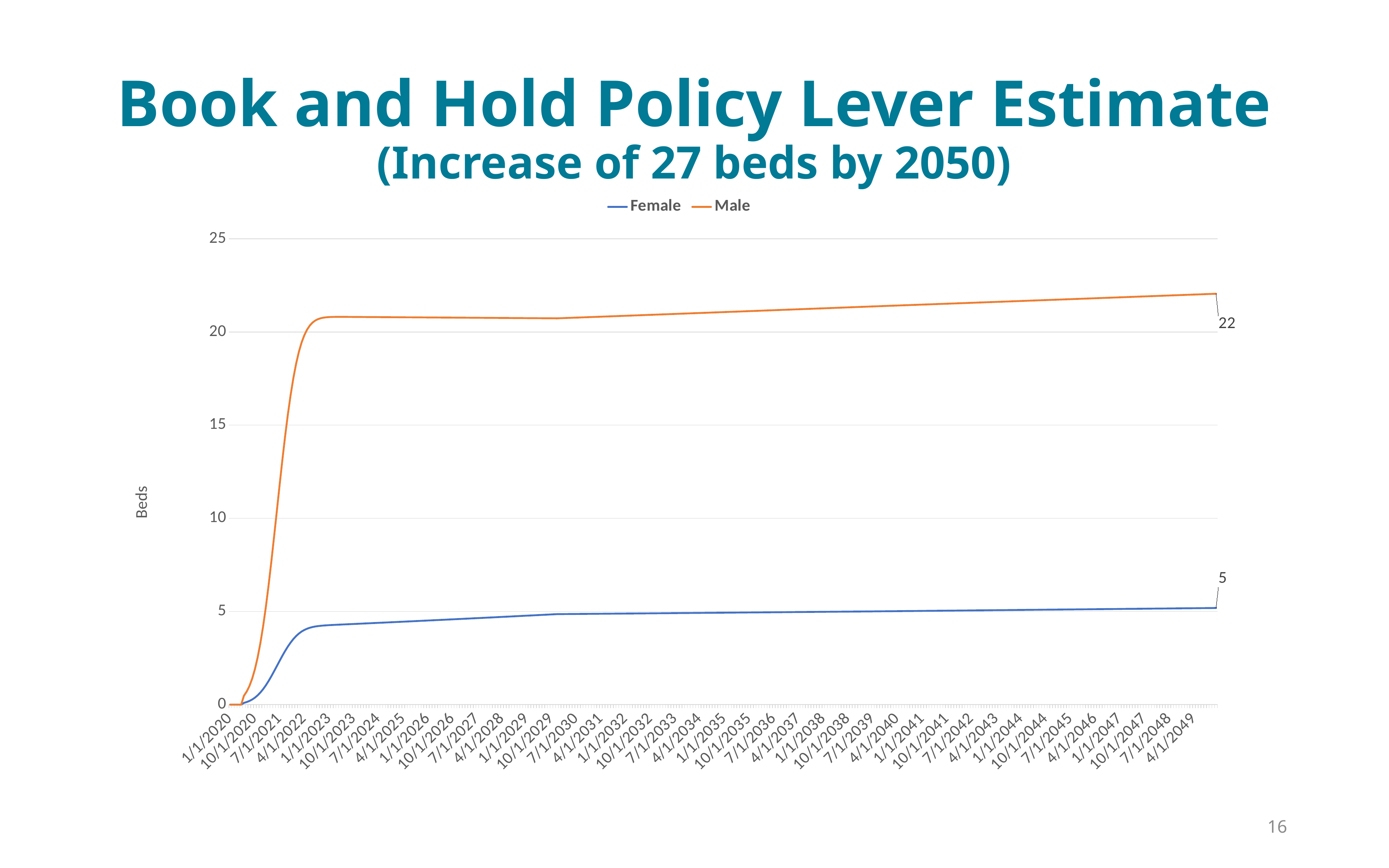
What is the title of the vertical axis? Beds Which series ends at a higher value, Male or Female? Male Which series has the higher values throughout the chart? Male What kind of chart is shown on the slide? line chart What is the sum of the final labelled values of the Male and Female series? 27 What is the difference between the final labelled values of the Male and Female series? 17 Is the value for the Female series at 1/1/2023 greater or less than 5? less How many series does the legend list? 2 What is the final labelled value for the Male series? 22 Does the Male series rise or fall from 1/1/2020 to 4/1/2049? rise What is the final labelled value for the Female series? 5 Is the value for the Male series at 1/1/2030 greater or less than 20? greater